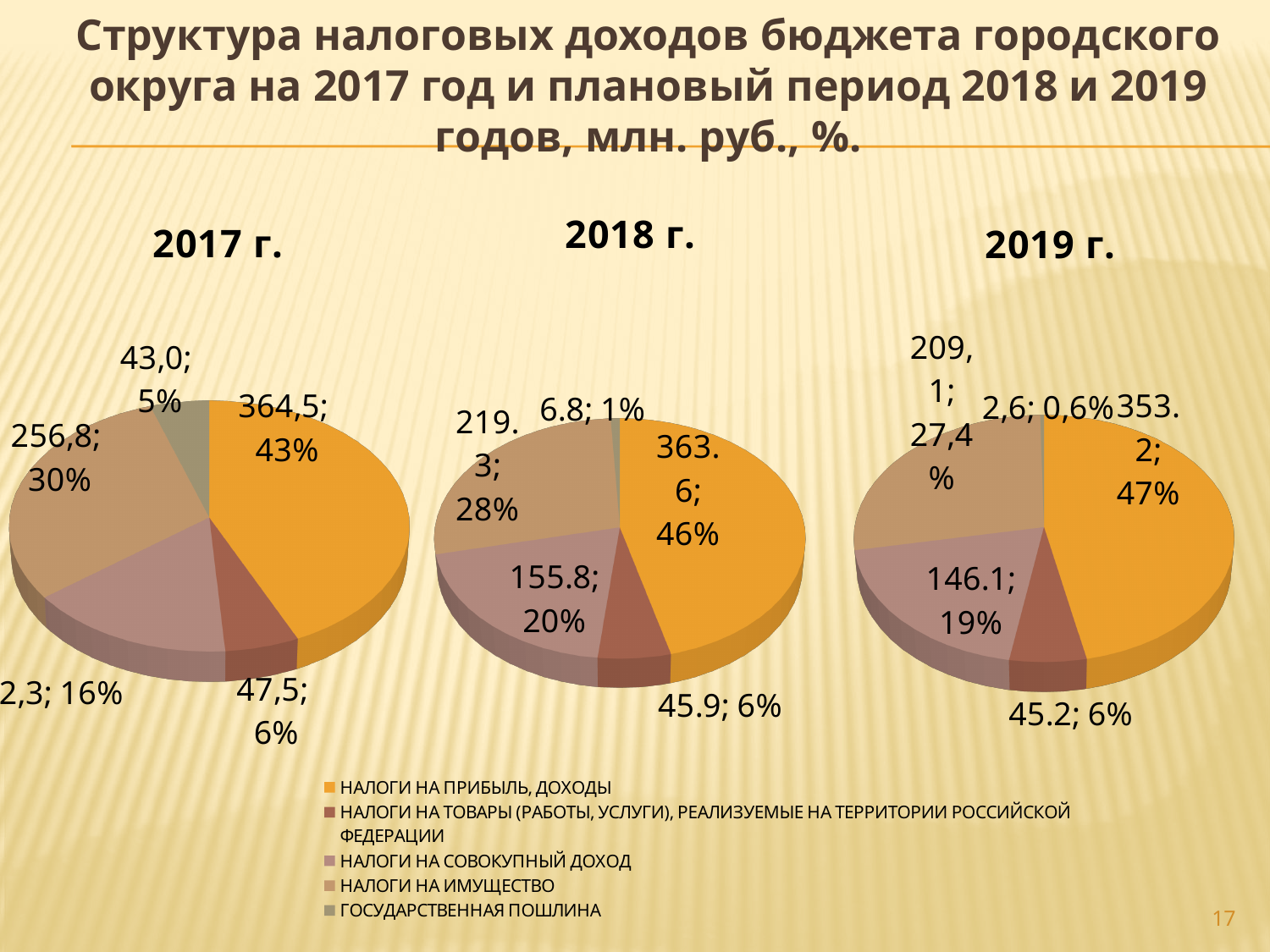
In the 2018 г. chart, what is the value for НАЛОГИ НА СОВОКУПНЫЙ ДОХОД? 155.8 In the 2019 г. chart, which category has the largest slice? НАЛОГИ НА ПРИБЫЛЬ, ДОХОДЫ What kind of charts are shown on the slide? Pie charts In the 2017 г. chart, what share of the pie is НАЛОГИ НА ИМУЩЕСТВО? 30% In the 2018 г. chart, which category has the smallest slice? ГОСУДАРСТВЕННАЯ ПОШЛИНА In the 2018 г. chart, what share of the pie is НАЛОГИ НА ПРИБЫЛЬ, ДОХОДЫ? 46% In the 2017 г. chart, what share of the pie is ГОСУДАРСТВЕННАЯ ПОШЛИНА? 5% Which is larger: НАЛОГИ НА ИМУЩЕСТВО in the 2018 г. chart or in the 2019 г. chart? 2018 г. In the 2019 г. chart, what is the value for НАЛОГИ НА ТОВАРЫ (РАБОТЫ, УСЛУГИ), РЕАЛИЗУЕМЫЕ НА ТЕРРИТОРИИ РОССИЙСКОЙ ФЕДЕРАЦИИ? 45.2 In the 2017 г. chart, what is the value for НАЛОГИ НА ПРИБЫЛЬ, ДОХОДЫ? 364,5 How many series does the legend list? 5